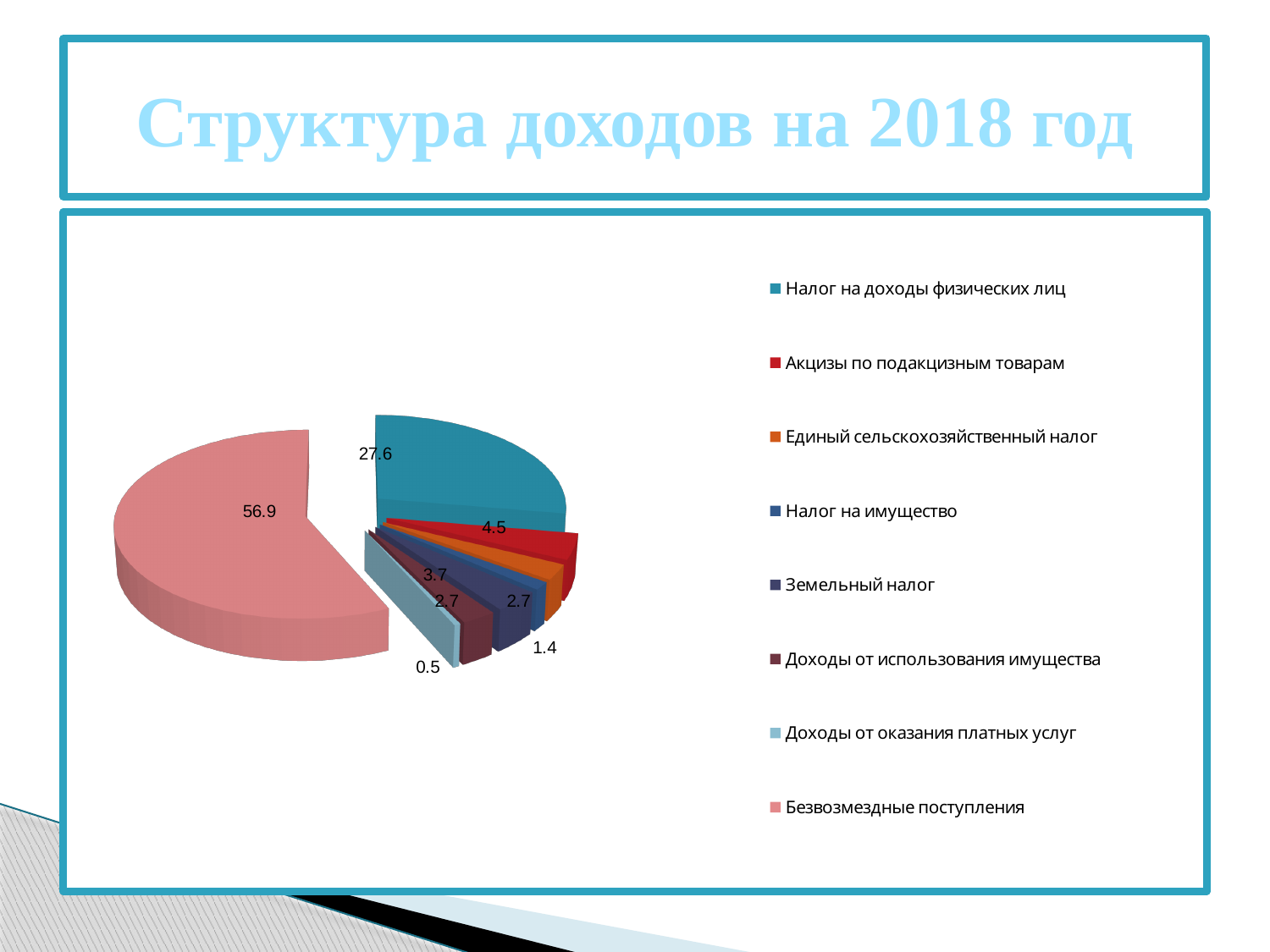
What type of chart is shown on the slide? pie chart What is the value shown for Доходы от оказания платных услуг? 0.5 How many entries are listed in the legend? 8 What is the value shown for Безвозмездные поступления? 56.9 What is the value shown for Акцизы по подакцизным товарам? 4.5 What is the difference between the values for Безвозмездные поступления and Налог на доходы физических лиц? 29.3 How many slices does the pie chart have? 8 Which category has the smallest slice of the pie? Доходы от оказания платных услуг What is the value shown for Налог на доходы физических лиц? 27.6 Which category has the largest slice of the pie? Безвозмездные поступления What is the title of the slide containing the chart? Структура доходов на 2018 год Which is larger: Налог на доходы физических лиц or Акцизы по подакцизным товарам? Налог на доходы физических лиц